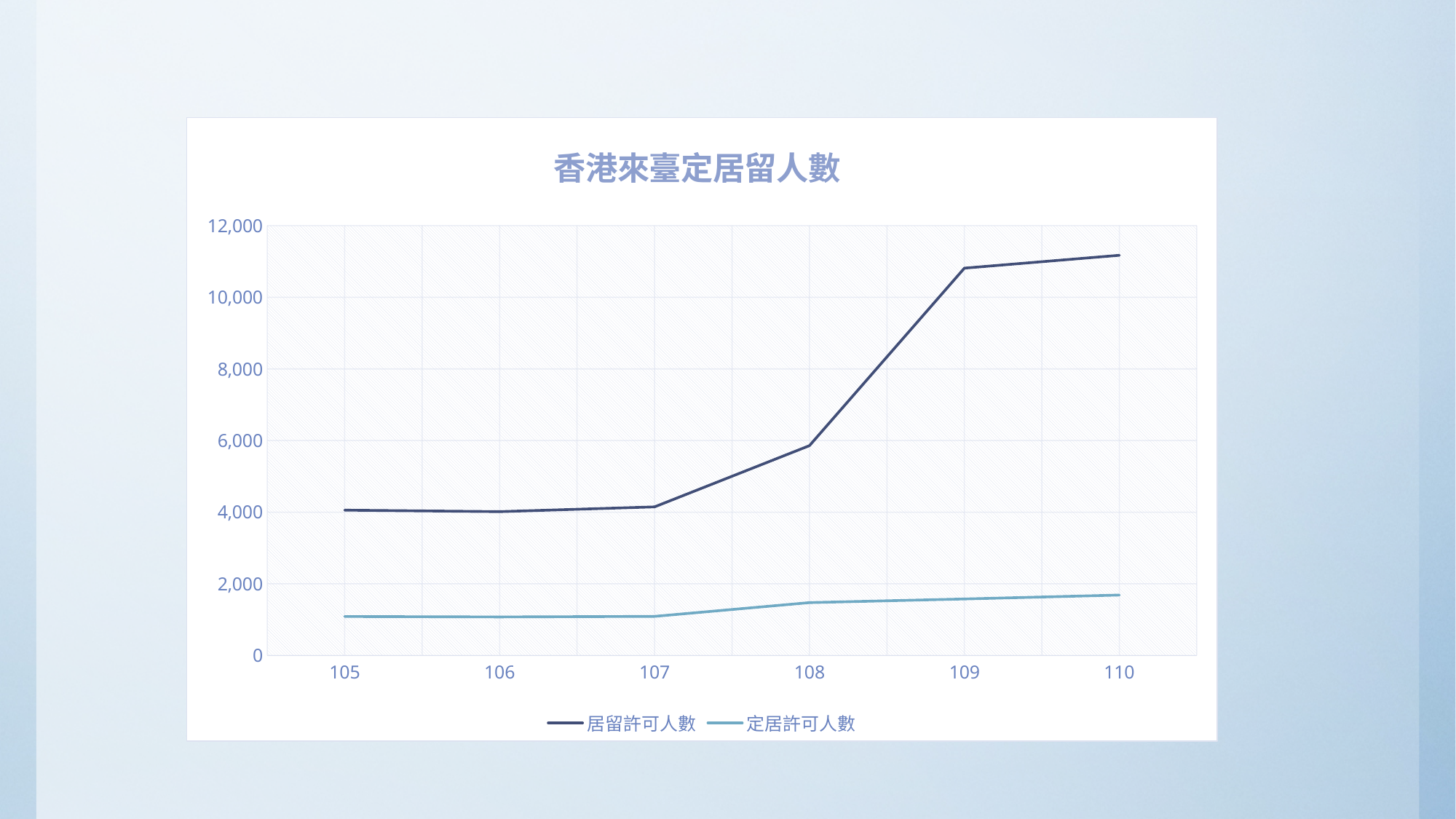
Does the 居留許可人數 series rise or fall from 107 to 109? rise Which year has the highest value for 居留許可人數? 110 Which series has the larger value in 110, 居留許可人數 or 定居許可人數? 居留許可人數 Is the value for 定居許可人數 in 110 greater or less than 2,000? less Is the value for 居留許可人數 in 108 greater or less than 6,000? less Is the value for 居留許可人數 in 109 greater or less than 10,000? greater Which series is drawn in the lighter blue line? 定居許可人數 How many series does the legend list? 2 How many points are plotted along the x axis for each series? 6 What type of chart is shown on the slide? line chart What is the title of the chart? 香港來臺定居留人數